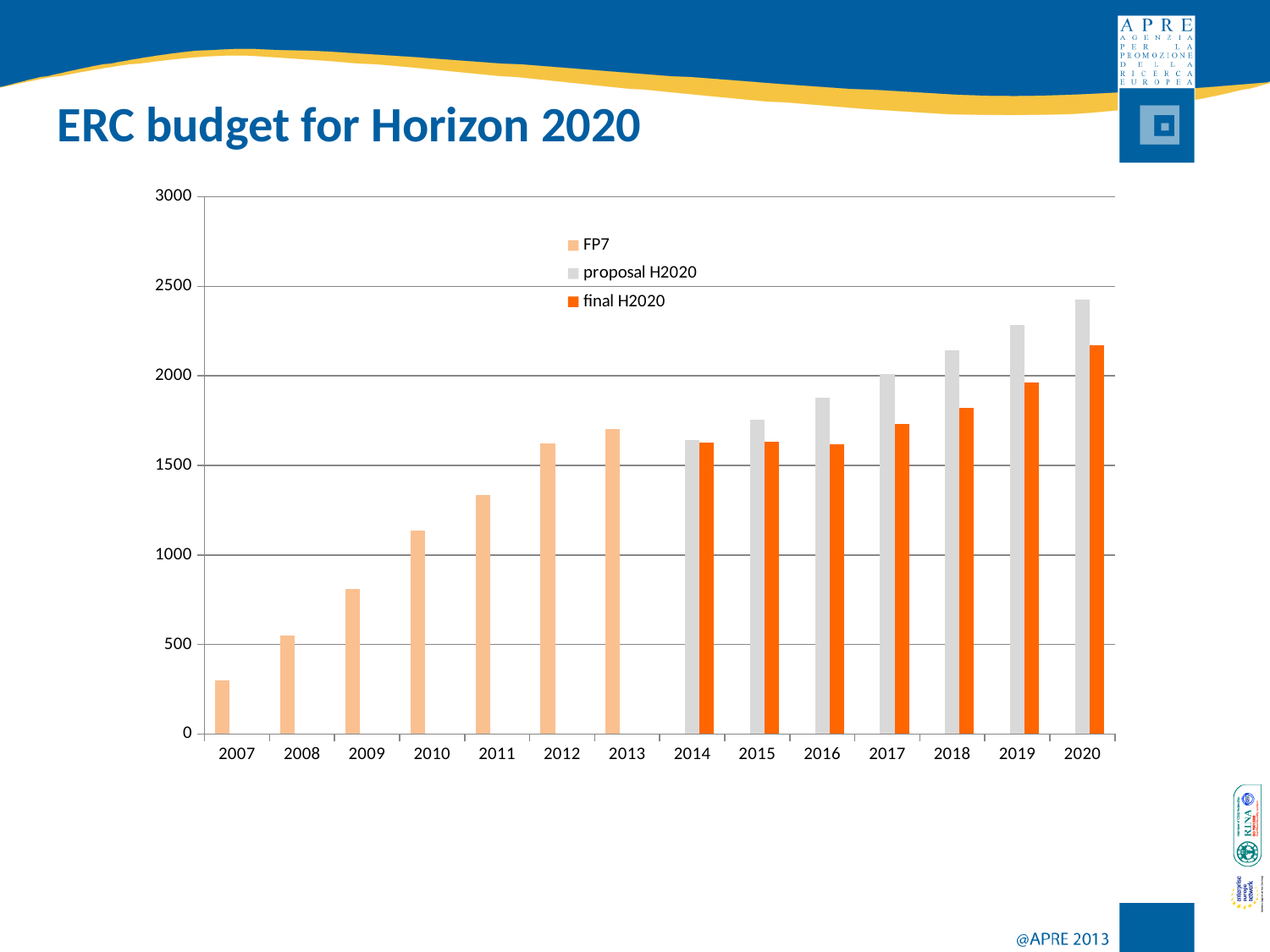
Do the proposal H2020 values rise or fall from 2014 to 2020? rise Is the final H2020 value for 2019 greater or less than 2000? less How many series does the legend list? 3 Which year has the lowest FP7 value? 2007 What is the title of the chart? ERC budget for Horizon 2020 How many years are shown on the x axis? 14 In 2020, which is larger: proposal H2020 or final H2020? proposal H2020 What kind of chart is shown on the slide? bar chart Is the FP7 value for 2007 greater or less than 500? less Is the proposal H2020 value for 2020 greater or less than 2000? greater Which year has the highest proposal H2020 value? 2020 Which year has the highest FP7 value? 2013